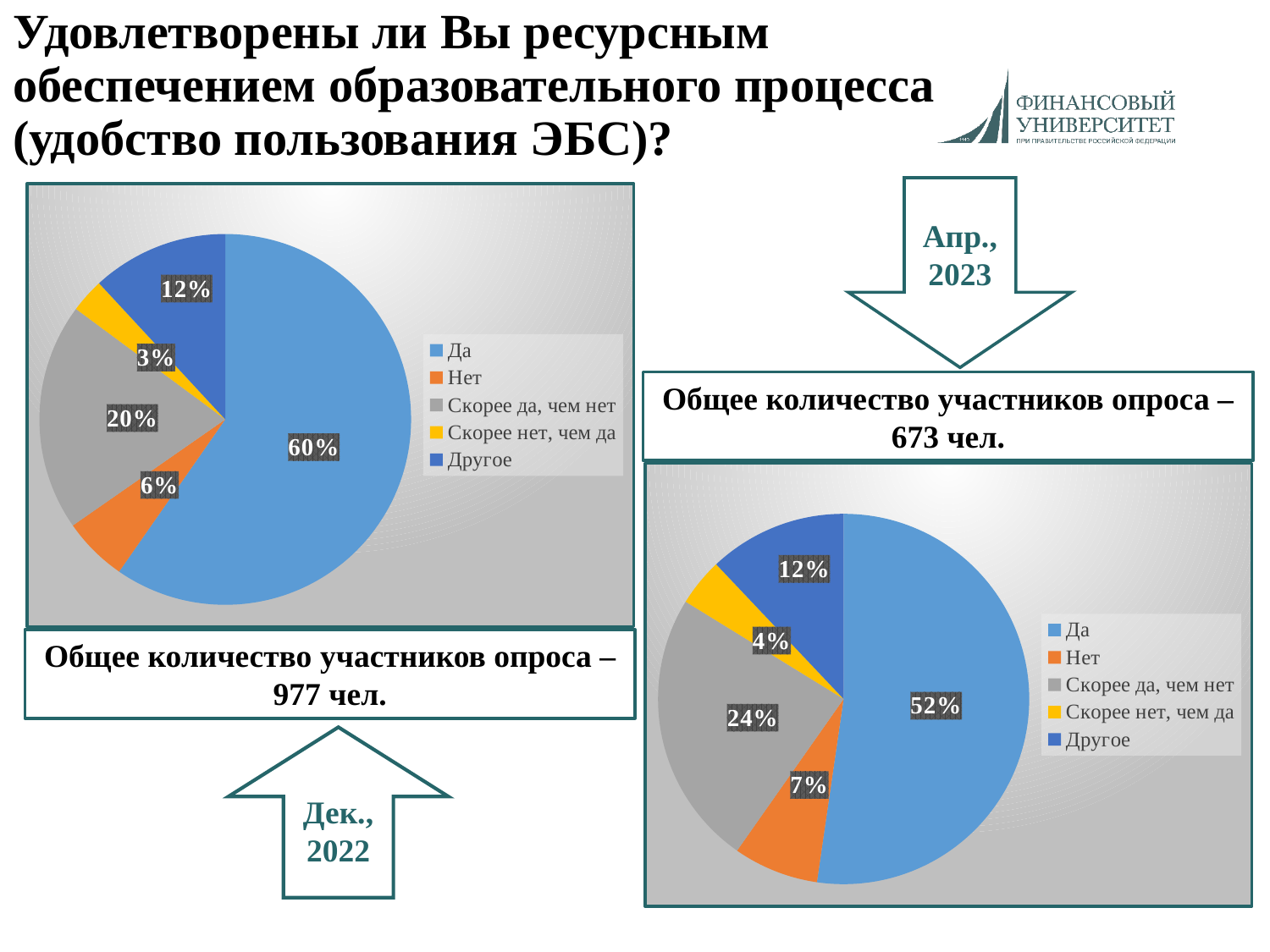
What type of chart is shown on the right side of the slide (Apr. 2023)? Pie chart In the right pie chart (Apr. 2023), which is larger: the "Скорее да, чем нет" slice or the "Другое" slice? Скорее да, чем нет In the left pie chart (Dec. 2022), what share is labelled for "Скорее да, чем нет"? 20% What is the difference between the "Да" share in the left pie chart (Dec. 2022) and the "Да" share in the right pie chart (Apr. 2023)? 8% In the left pie chart (Dec. 2022), which category has the smallest slice? Скорее нет, чем да In the right pie chart (Apr. 2023), what share is labelled for "Нет"? 7% How many entries does the legend of the right pie chart (Apr. 2023) list? 5 In the right pie chart (Apr. 2023), which category has the largest slice? Да In the left pie chart (Dec. 2022), what share is labelled for "Да"? 60% In the left pie chart (Dec. 2022), what share is labelled for "Другое"? 12% How many slices does the left pie chart (Dec. 2022) have? 5 In the right pie chart (Apr. 2023), what share is labelled for "Да"? 52%